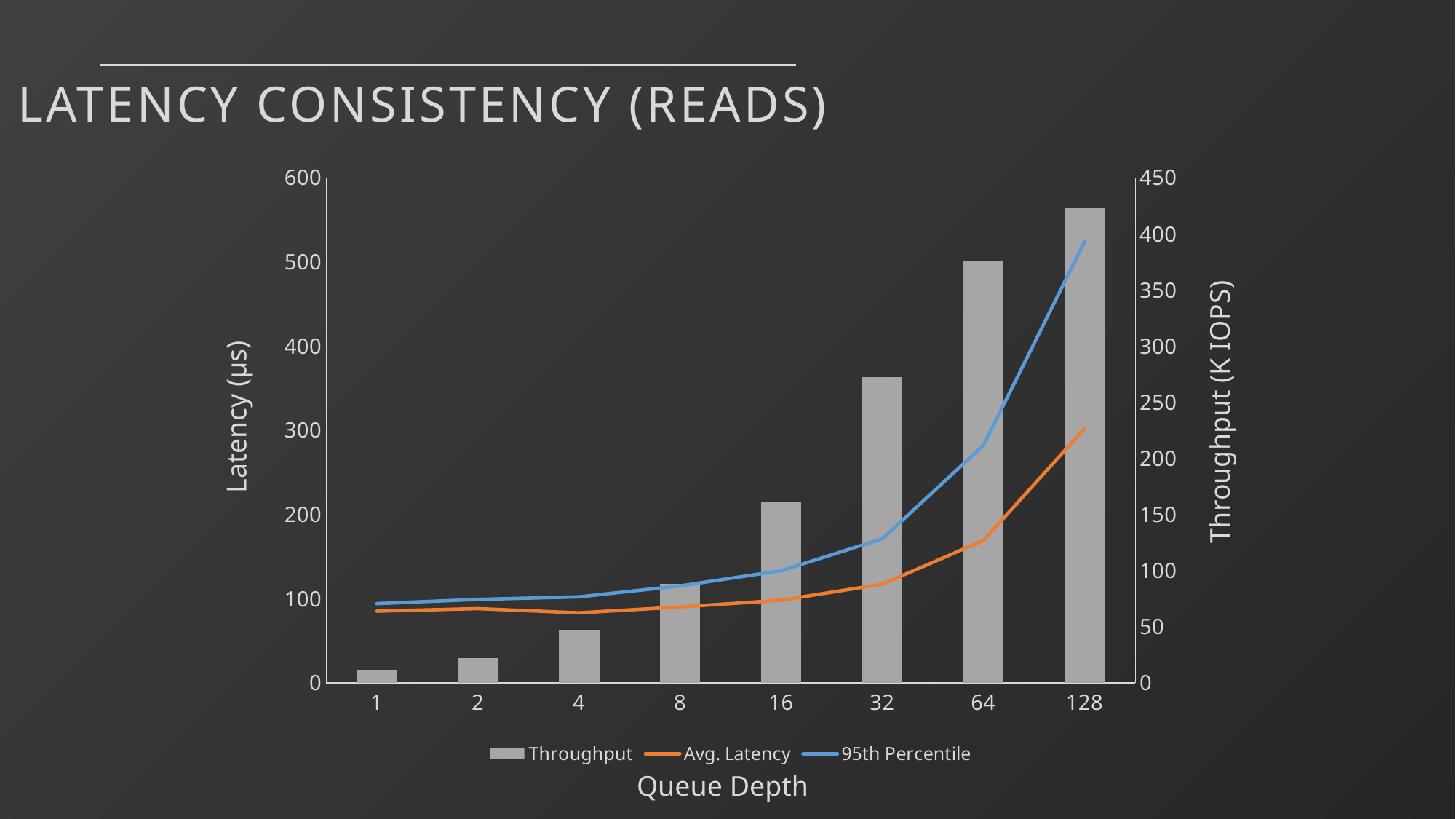
Is the Throughput value at queue depth 32 greater or less than 200? greater How many series does the legend list? 3 Does Throughput rise or fall as queue depth increases along the x axis? Rises What kind of chart is shown on the slide? A combination bar and line chart What is the label of the right-hand vertical axis? Throughput (K IOPS) How many queue depth categories are plotted on the x axis? 8 At which queue depth is Throughput highest? 128 Is the Throughput value at queue depth 128 greater or less than 350? greater Is the 95th Percentile value at queue depth 128 greater or less than 400? greater At queue depth 128, which is larger: Avg. Latency or 95th Percentile? 95th Percentile At which queue depth is Throughput lowest? 1